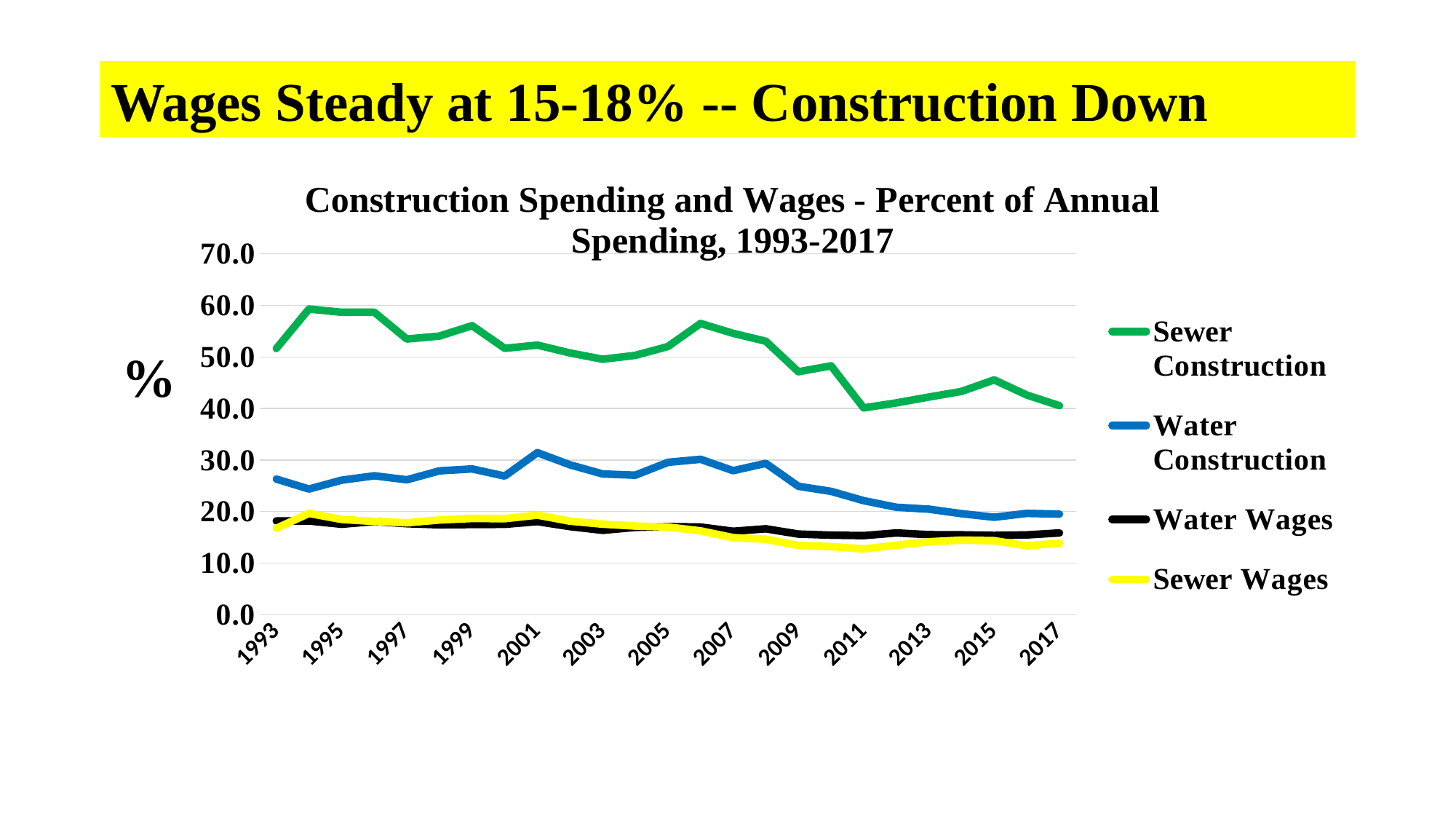
Does the Water Construction line rise or fall from 2007 to 2017? fall What is the title of the chart? Construction Spending and Wages - Percent of Annual Spending, 1993-2017 Is the value for Sewer Construction in 1995 greater or less than 50.0? greater How many series does the legend list? 4 What kind of chart is shown on the slide? line chart Which series has the highest values across the whole period? Sewer Construction Which is larger in 2001, Water Construction or Water Wages? Water Construction Is the value for Sewer Wages in 2011 greater or less than 20.0? less Which is larger in 2011, Sewer Construction or Water Construction? Sewer Construction Which series is plotted with a green line? Sewer Construction Is the value for Water Construction in 2017 greater or less than 30.0? less Does the Sewer Construction line rise or fall from 1993 to 2017? fall